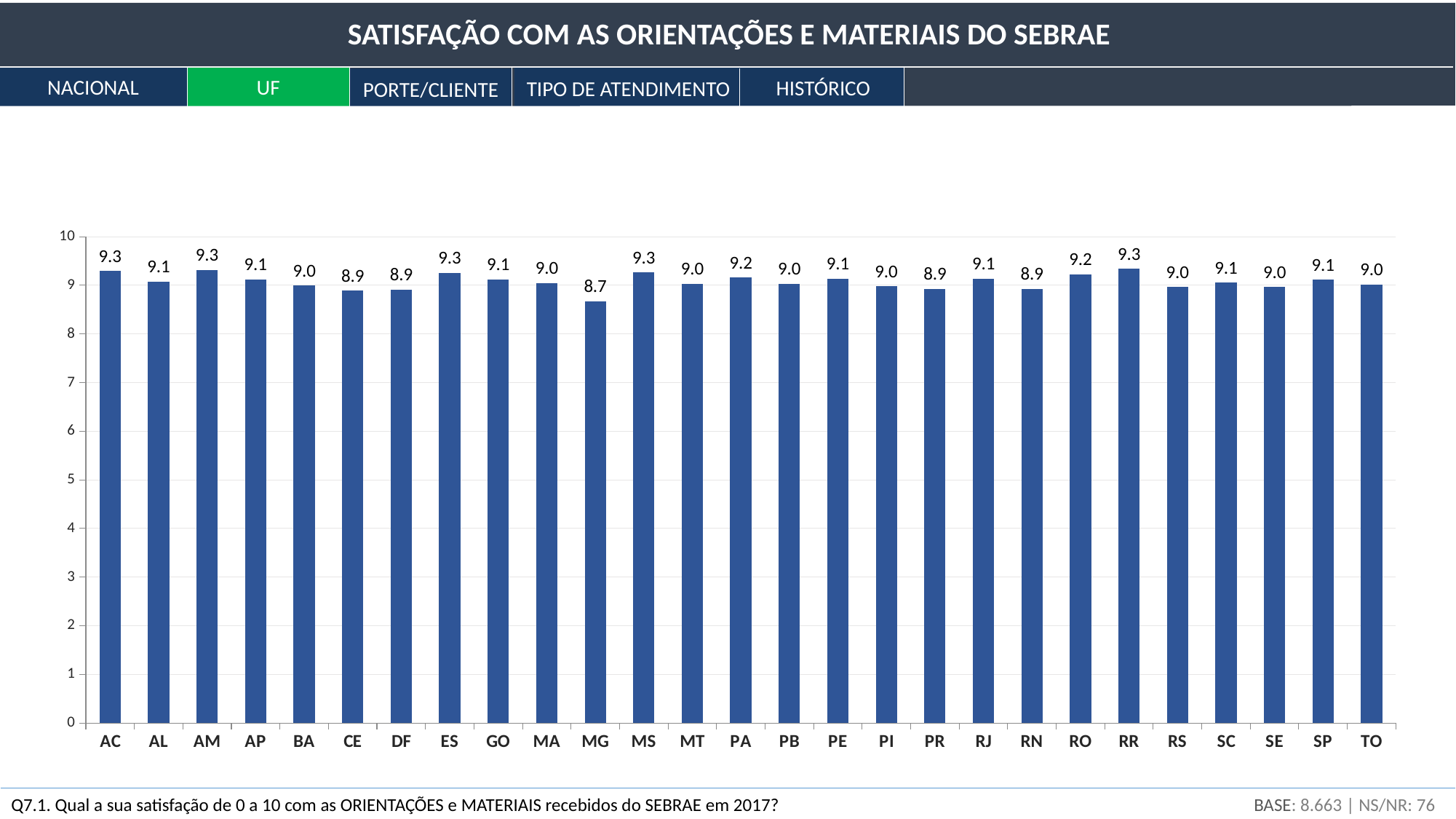
What is the difference between the values for AC and MG? 0.6 What is the value for MG? 8.7 Which is larger, the value for MS or the value for MG? MS What is the title of the slide? SATISFAÇÃO COM AS ORIENTAÇÕES E MATERIAIS DO SEBRAE Is the value for MG greater or less than 9? less What is the value for CE? 8.9 What is the value for PA? 9.2 What is the difference between the values for PA and CE? 0.3 What kind of chart is shown on the slide? bar chart What is the value for RR? 9.3 Which state (UF) has the lowest value? MG How many states (UF) are shown on the x axis? 27